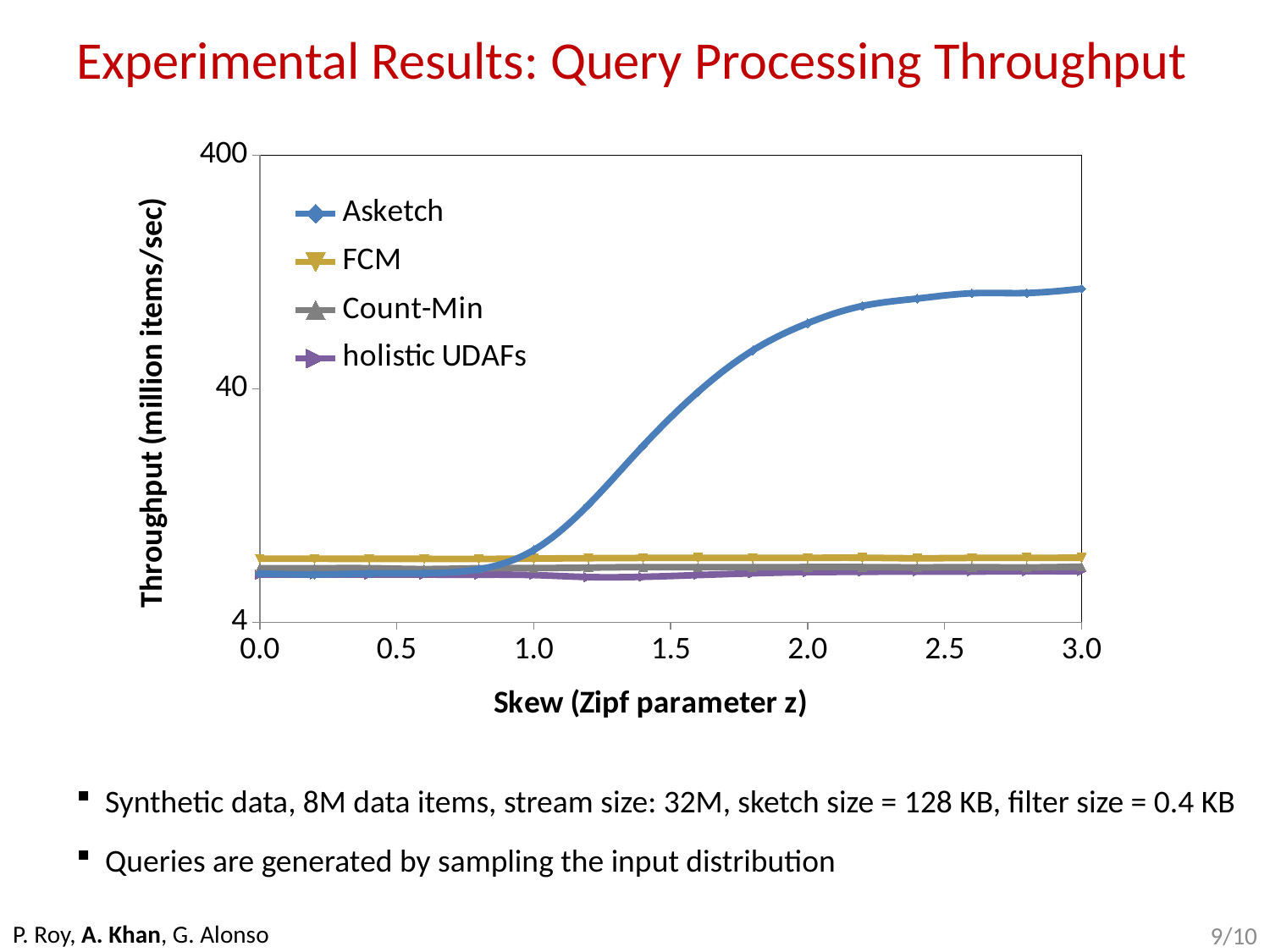
What kind of chart is shown on the slide? line chart Does the throughput of Asketch rise or fall as the skew increases from 1.0 to 3.0? rise At skew z = 2.0, which series has the larger throughput, Asketch or holistic UDAFs? Asketch Is the throughput of FCM at skew z = 3.0 greater or less than 40? less What is the title of the x axis? Skew (Zipf parameter z) How many series does the legend list? 4 Is the throughput of Asketch at skew z = 3.0 greater or less than 40? greater How many tick labels are shown on the x axis? 7 Is the throughput of Asketch at skew z = 0.0 greater or less than 40? less Which series is listed first in the legend? Asketch Which series has the highest throughput at skew z = 3.0? Asketch